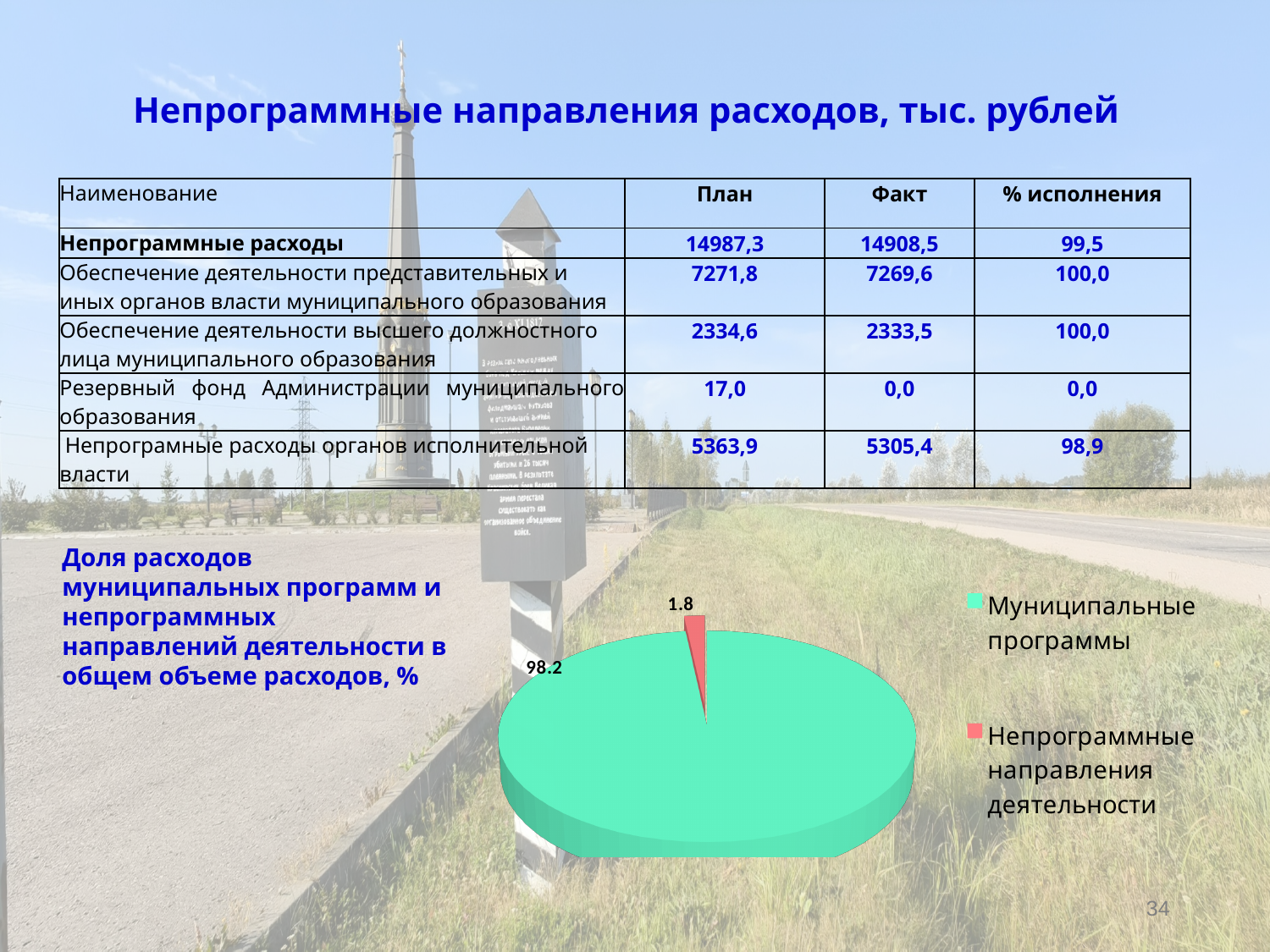
What kind of chart is shown on the slide? pie chart What share of the pie does the Непрограммные направления деятельности slice represent? 1.8 What colour is the Непрограммные направления деятельности slice in the pie chart? red How many slices does the pie chart have? 2 Which slice of the pie chart is the largest? Муниципальные программы What colour is the Муниципальные программы slice in the pie chart? green How many entries does the legend of the pie chart list? 2 What is the value shown for Муниципальные программы in the pie chart? 98.2 What is the difference between the values for Муниципальные программы and Непрограммные направления деятельности in the pie chart? 96.4 What is the value shown for Непрограммные направления деятельности in the pie chart? 1.8 Which slice of the pie chart is the smallest? Непрограммные направления деятельности Which is larger in the pie chart: Муниципальные программы or Непрограммные направления деятельности? Муниципальные программы